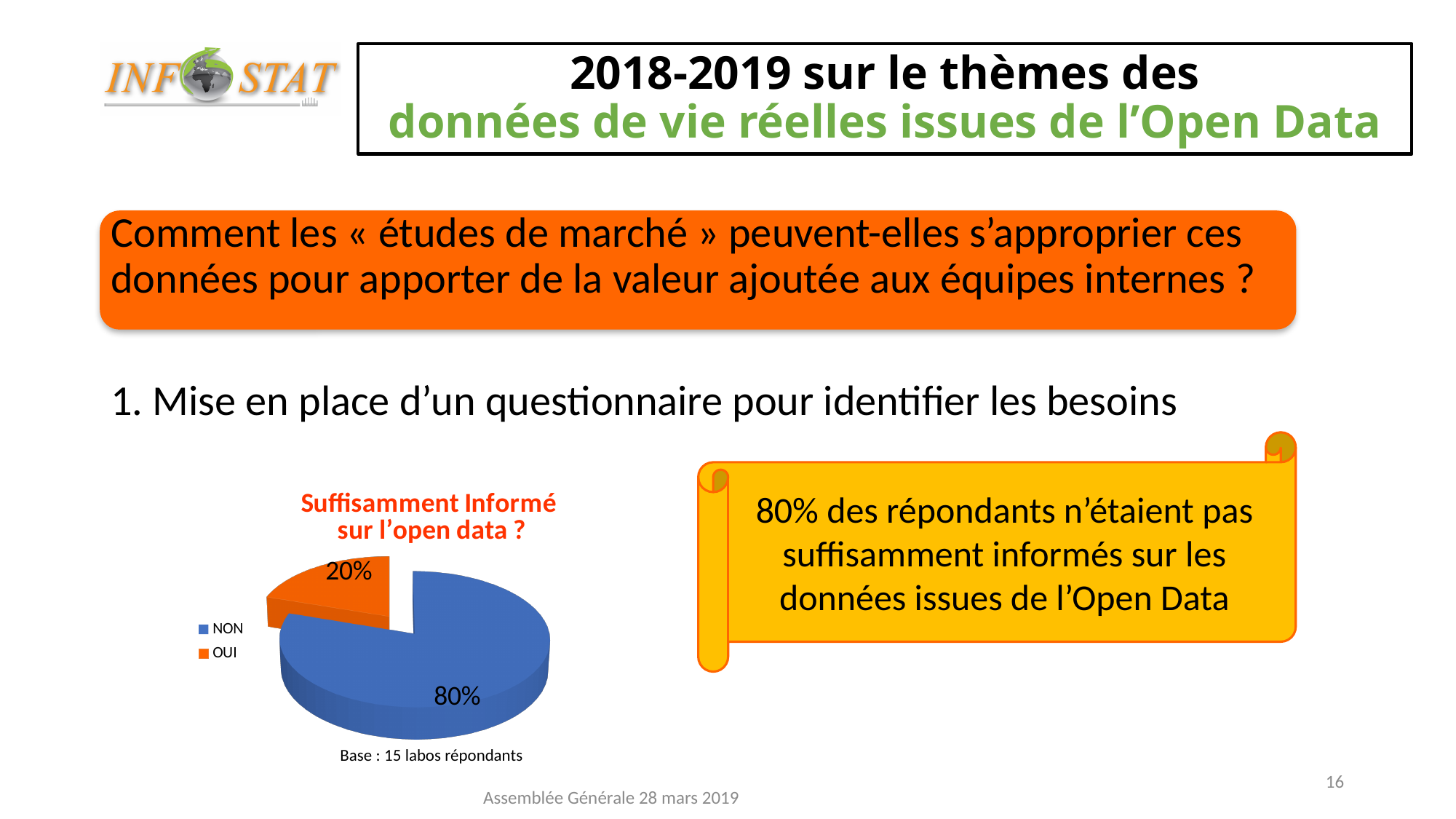
What share of the pie does NON represent? 80% What share of the pie does OUI represent? 20% Is the share for NON greater or less than 50%? greater Which category has the largest slice of the pie? NON Which is larger, the NON slice or the OUI slice? NON What is the title of the pie chart? Suffisamment Informé sur l'open data ? Which category has the smallest slice of the pie? OUI How many entries does the legend list? 2 What is the difference between the NON and OUI shares? 60% How many categories does the pie chart have? 2 What kind of chart is shown on the slide? pie chart What colour is the OUI slice? orange